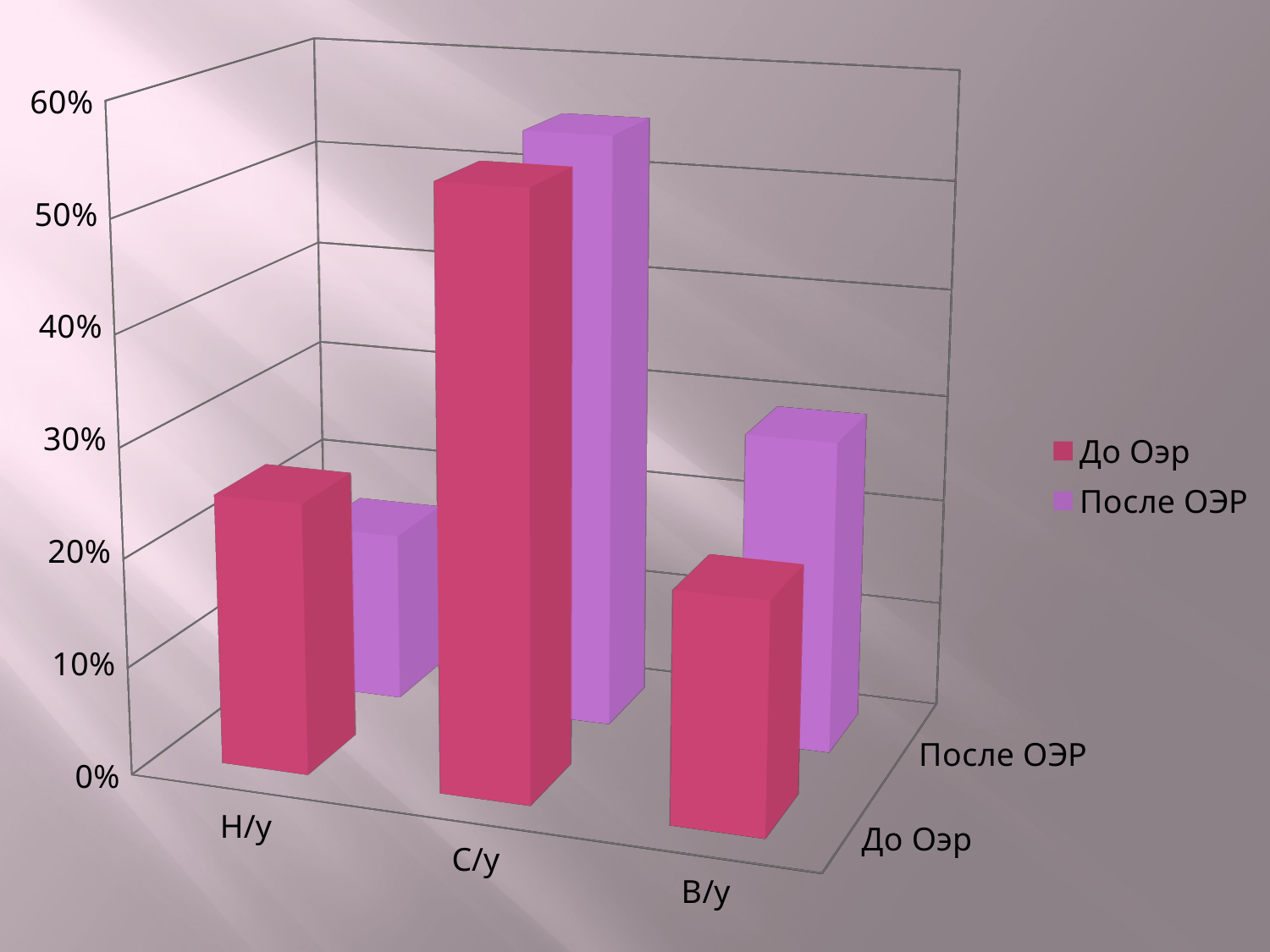
Which category has the lowest value for the После ОЭР series? Н/у Is the value for Н/у in the После ОЭР series greater or less than 30%? less Which colour represents the После ОЭР series in the chart? purple Is the value for С/у in the До Оэр series greater or less than 40%? greater For the category В/у, which series has the larger value, До Оэр or После ОЭР? После ОЭР Is the value for Н/у in the До Оэр series greater or less than 20%? greater How many categories are shown on the x axis of the chart? 3 What kind of chart is shown on the slide? bar chart Which category has the highest value for the После ОЭР series? С/у Which category has the highest value for the До Оэр series? С/у How many series does the chart's legend list? 2